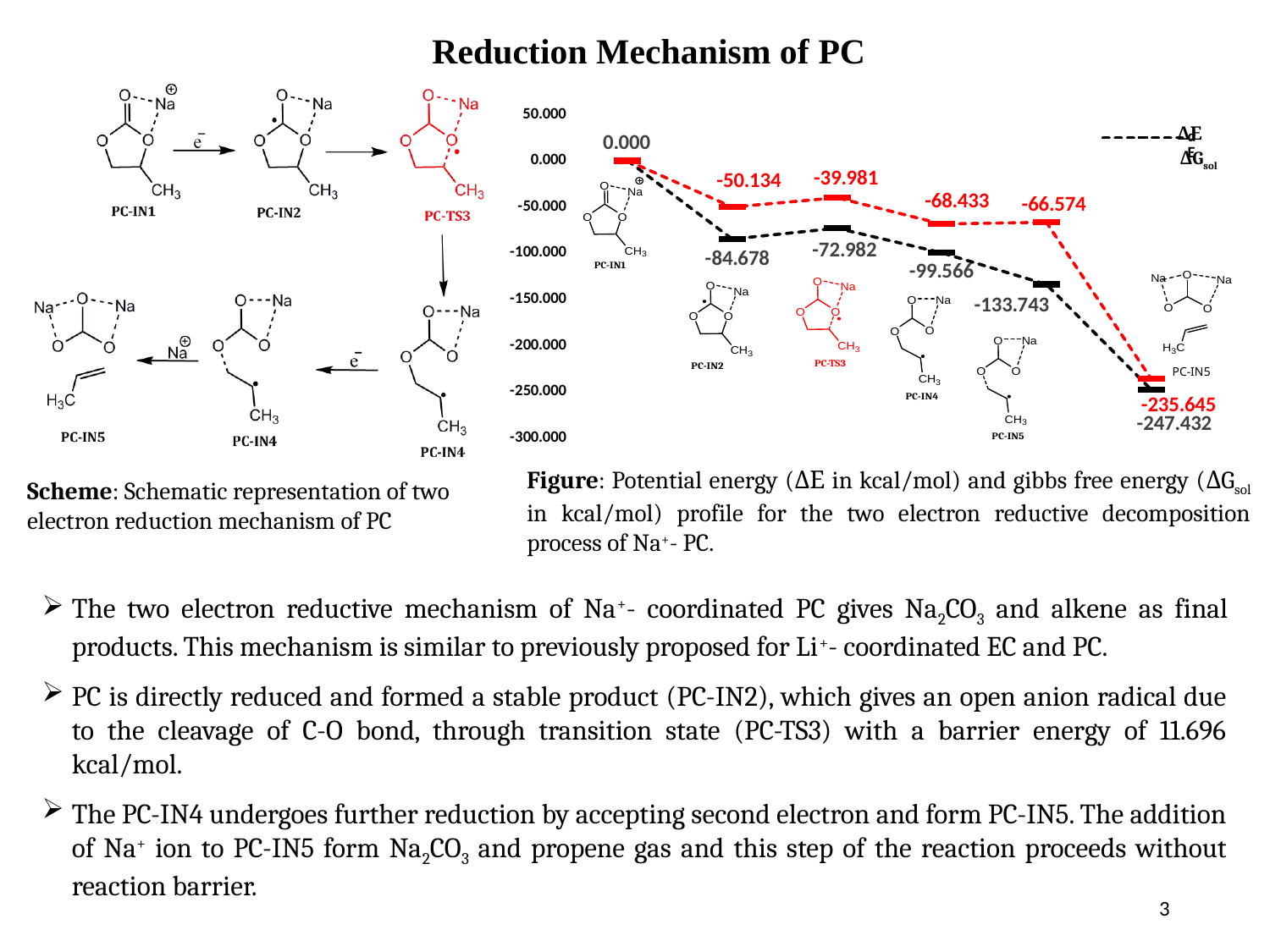
What is the ΔE value at PC-TS3 in the energy profile? -72.982 How many series does the legend of the energy profile list? 2 What is the ΔE value of the final point on the profile? -247.432 What is the lowest ΔG_sol value shown on the profile? -235.645 What is the ΔG_sol value at PC-IN4? -68.433 What is the ΔG_sol value at PC-TS3? -39.981 What is the difference in ΔG_sol between PC-IN2 and PC-TS3? 10.153 What is the ΔE value at PC-IN2? -84.678 Which colour is used for the ΔE series in the energy profile? Black What is the ΔE value at PC-IN4? -99.566 What is the ΔG_sol value at PC-IN2? -50.134 At PC-IN4, which is higher, the ΔE value or the ΔG_sol value? ΔG_sol